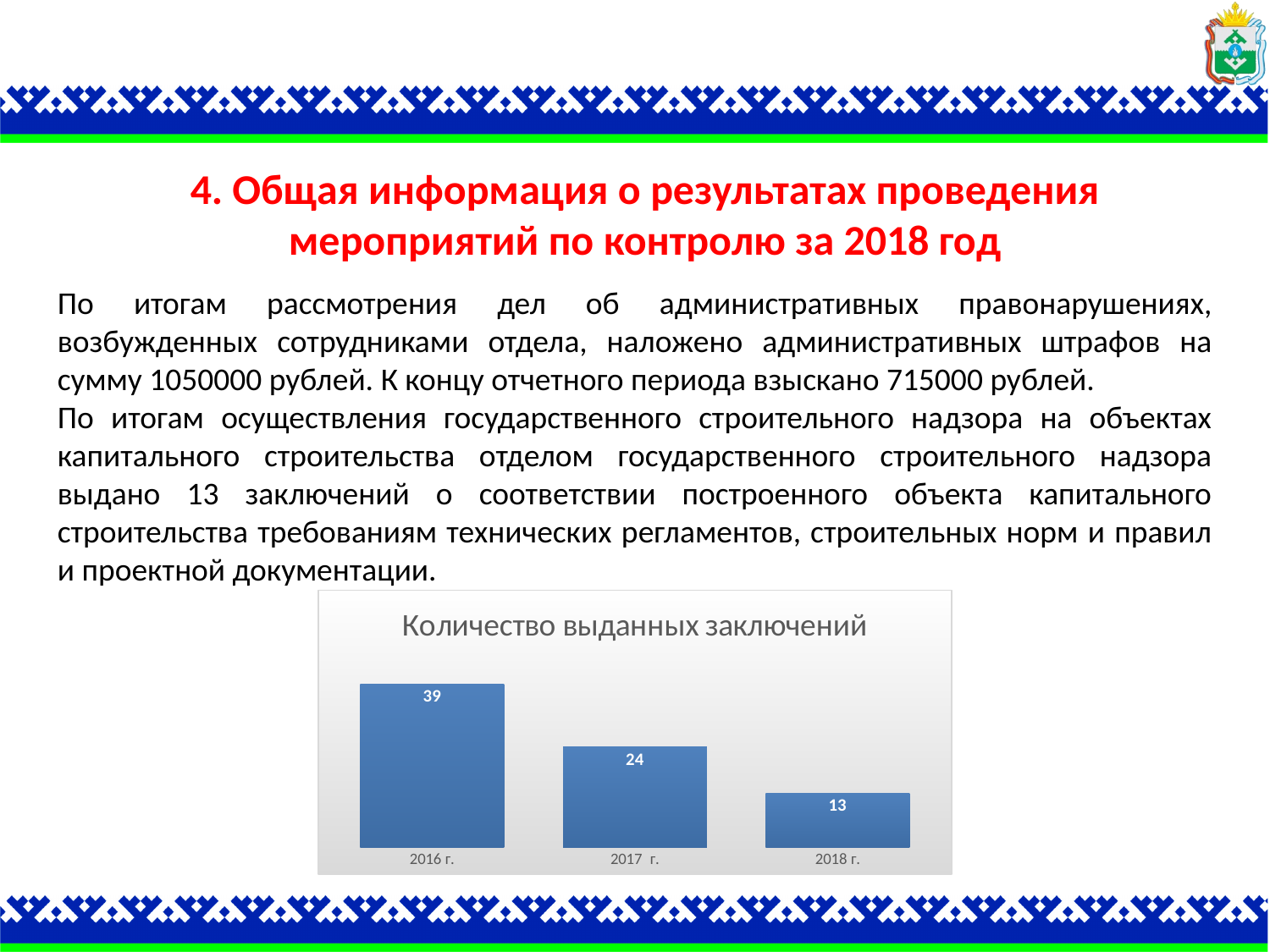
What is the title of the chart? Количество выданных заключений What is the difference between the values for 2016 г. and 2018 г.? 26 How many categories are shown in the chart? 3 Which is larger, the value for 2017 г. or the value for 2018 г.? 2017 г. What is the value for 2018 г. in the chart? 13 What kind of chart is shown on the slide? bar chart Which year has the highest number of issued conclusions? 2016 г. What is the difference between the values for 2016 г. and 2017 г.? 15 What is the value for 2017 г. in the chart? 24 What is the value for 2016 г. in the chart? 39 Do the values rise or fall from 2016 г. to 2018 г.? fall Which year has the lowest number of issued conclusions? 2018 г.